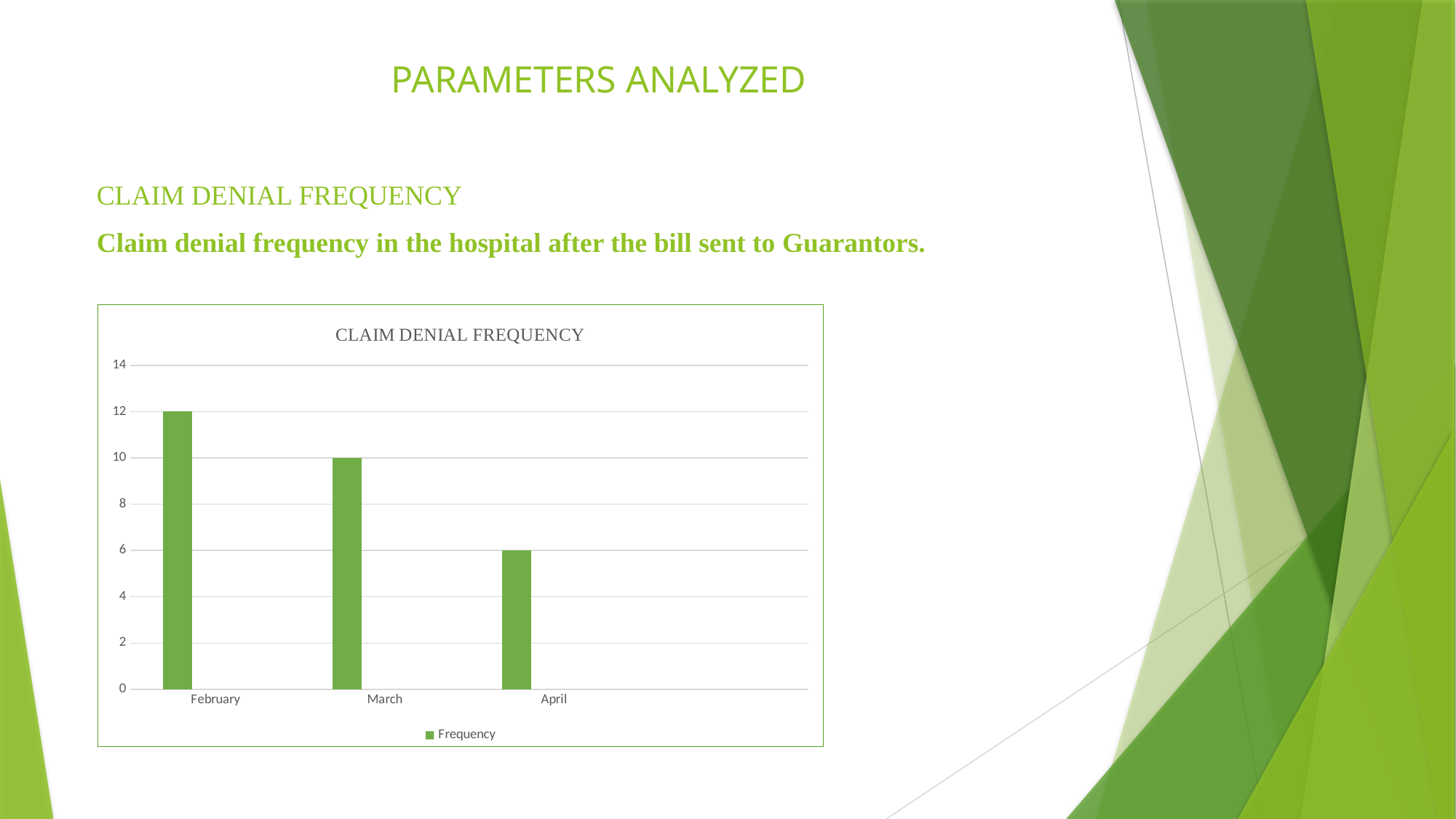
Which month has the lowest claim denial frequency? April What is the claim denial frequency for March? 10 Which month has a higher claim denial frequency, March or April? March What is the claim denial frequency for April? 6 How many series does the legend list? 1 What kind of chart is shown on the slide? Bar chart Do the claim denial frequency values rise or fall from February to April? Fall Is the claim denial frequency for March greater or less than 8? greater What is the claim denial frequency for February? 12 Which month has the highest claim denial frequency? February What is the difference between the claim denial frequency in February and in April? 6 How many months are shown on the chart? 3